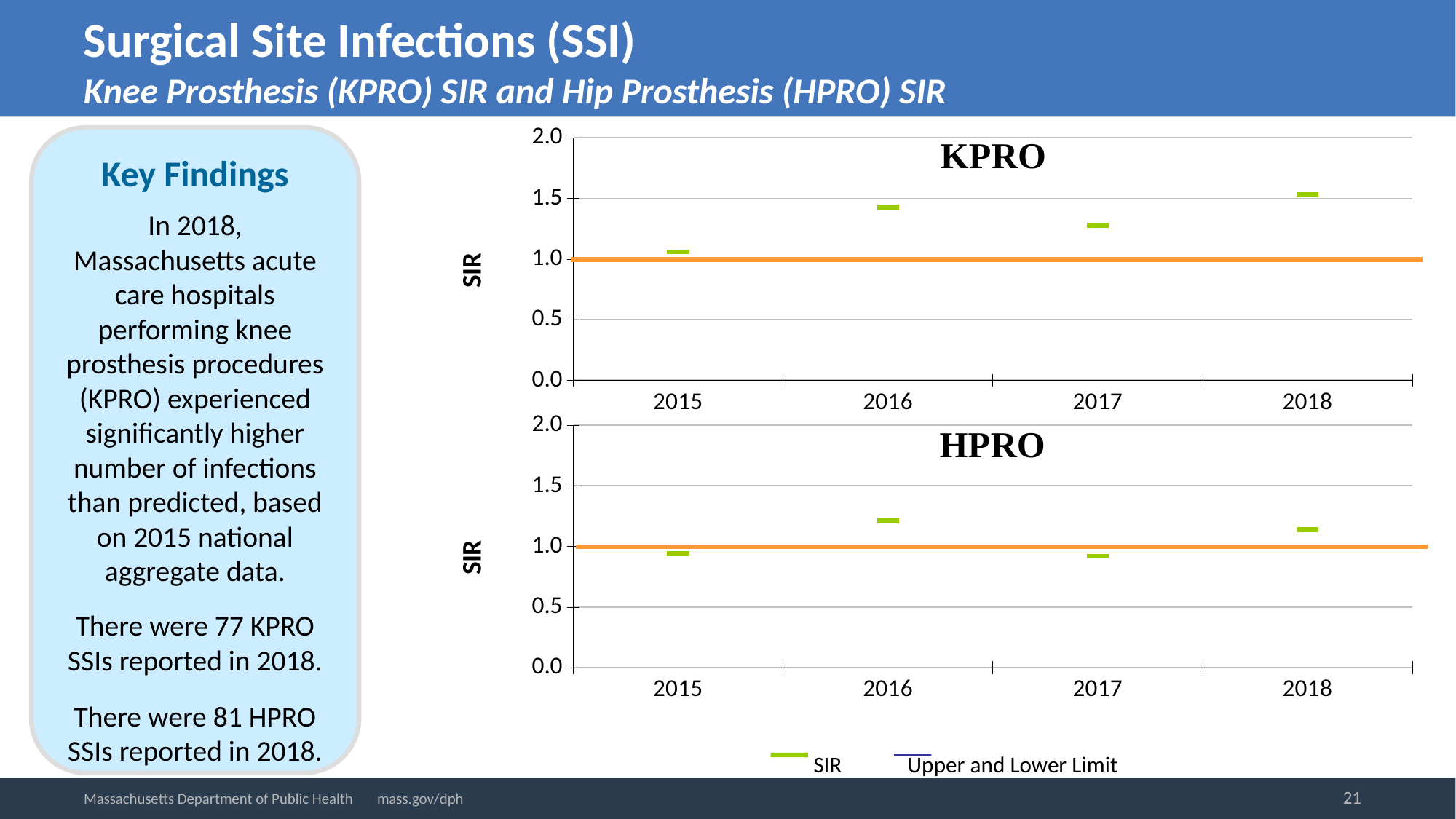
In the HPRO chart, is the SIR for 2015 greater or less than 1.0? less How many entries does the legend below the charts list? 2 In the HPRO chart, is the SIR for 2017 greater or less than 1.0? less In the KPRO chart, is the SIR for 2017 greater or less than 1.5? less In the KPRO chart, which year has the lowest SIR? 2015 In the KPRO chart, which year has the highest SIR? 2018 How many years are plotted in the HPRO chart? 4 In the KPRO chart, which year has a higher SIR, 2016 or 2017? 2016 In the HPRO chart, which year has the highest SIR? 2016